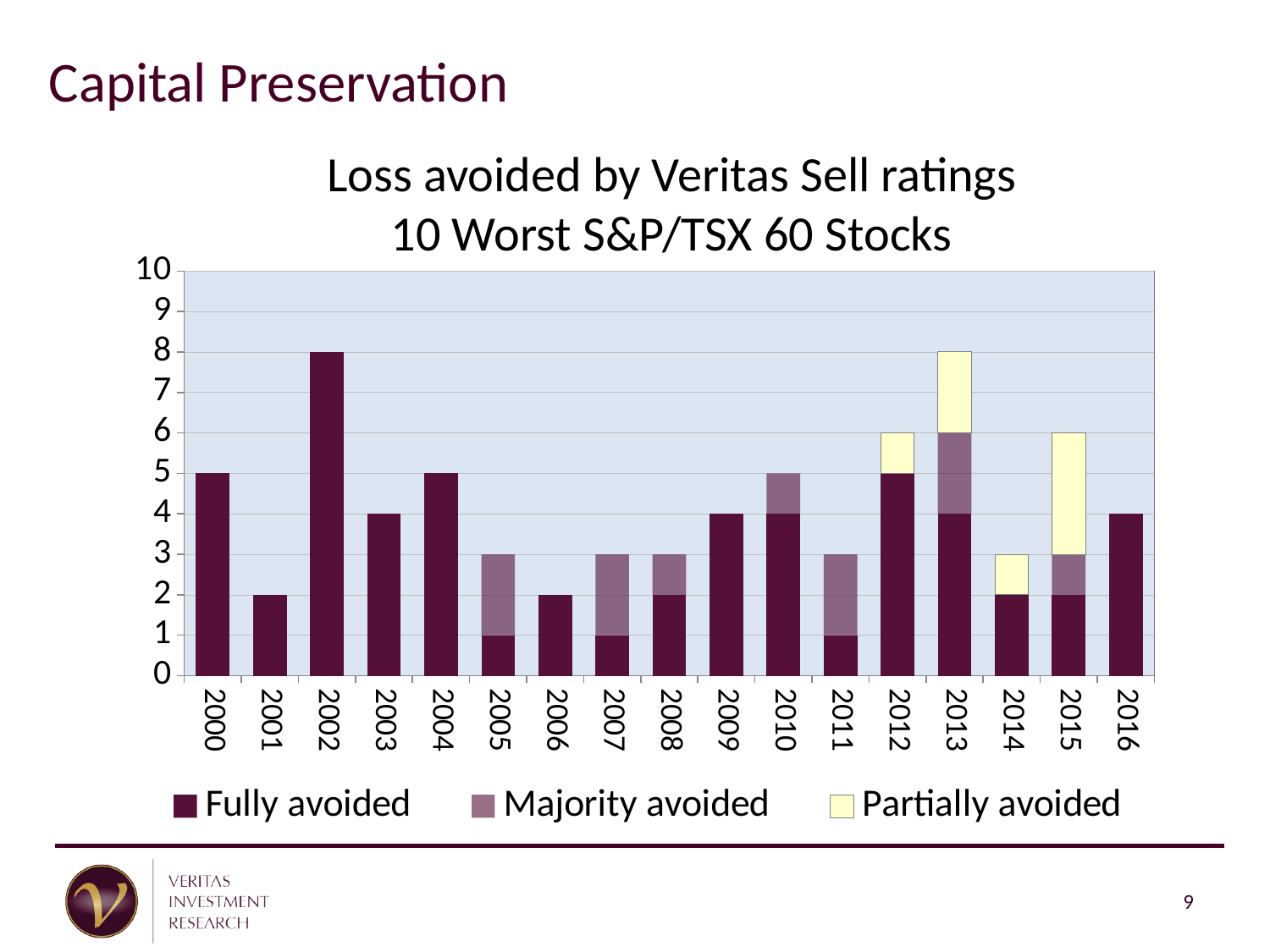
What is the total height of the stacked bar for 2013? 8 What is the title of the chart? Loss avoided by Veritas Sell ratings 10 Worst S&P/TSX 60 Stocks What is the Majority avoided value for 2010? 1 What kind of chart is shown on the slide? Stacked bar chart Which year has the larger total stacked bar, 2012 or 2010? 2012 What is the difference between the Fully avoided values for 2000 and 2001? 3 What is the Partially avoided value for 2015? 3 How many years are shown on the x axis? 17 Which year has the highest Fully avoided value? 2002 Is the total for 2002 greater or less than 5? greater How many series does the legend list? 3 What is the Fully avoided value for 2002? 8